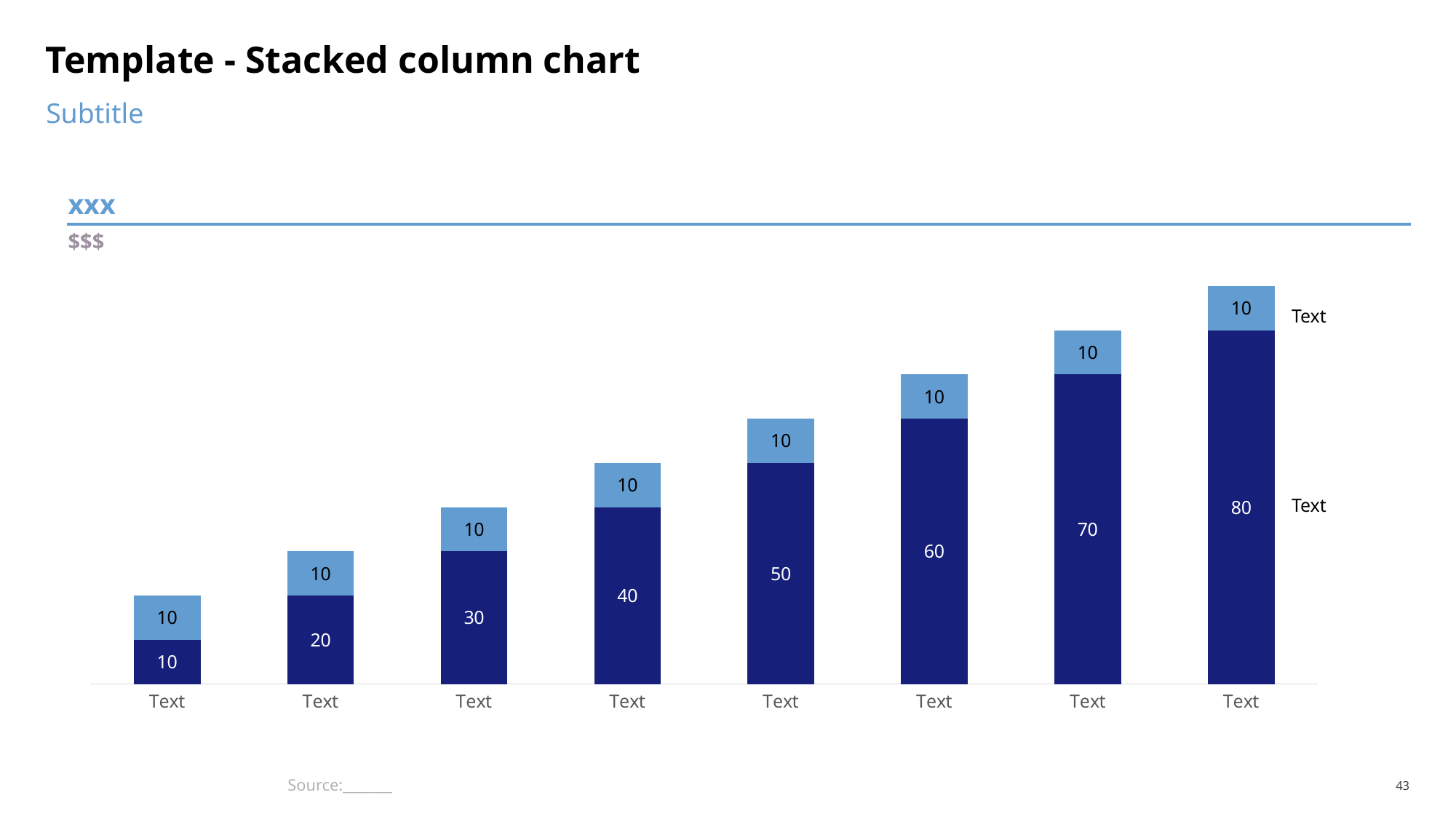
What is the difference between the dark blue segments of the rightmost and leftmost bars? 70 Which bar has the smallest total? the leftmost bar What kind of chart is shown on the slide? stacked bar chart How many bars does the chart have? 8 What is the value of the dark blue bottom segment of the rightmost bar? 80 What is the value of the dark blue bottom segment of the leftmost bar? 10 What is the total of the third stacked bar from the left? 40 Which bar has the largest dark blue bottom segment? the rightmost bar Do the bar totals rise or fall from left to right? rise What is the value of the dark blue bottom segment of the fifth bar from the left? 50 What is the value of the light blue top segment of the fourth bar from the left? 10 What is the total of the rightmost stacked bar? 90